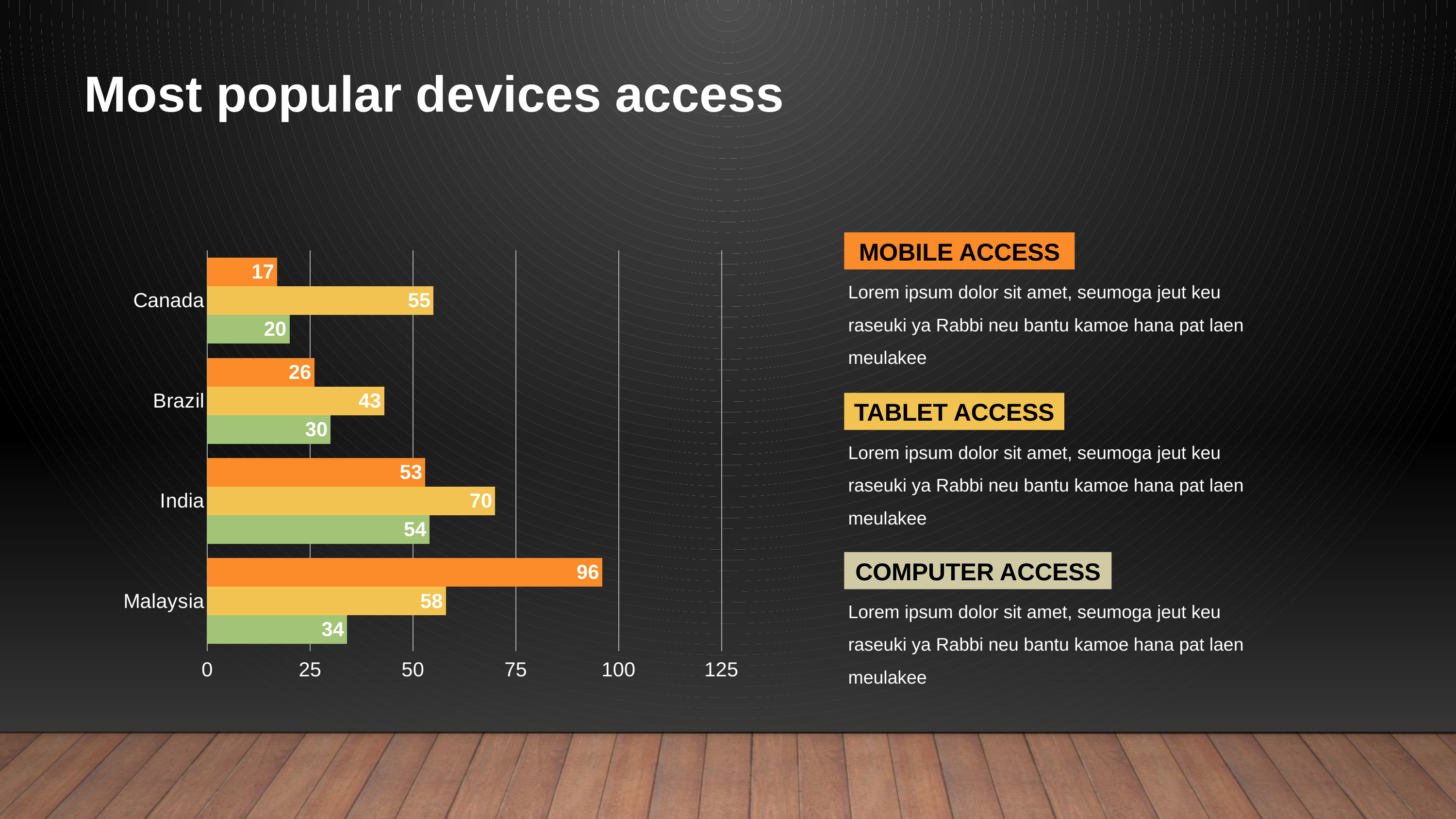
What is the Computer Access (green bar) value for Brazil? 30 Is the Mobile Access value for Malaysia greater or less than 75? greater What is the Mobile Access (orange bar) value for Malaysia? 96 What is the Tablet Access (yellow bar) value for India? 70 Which country has the lowest Computer Access (green bar) value? Canada What is the title of the slide containing the chart? Most popular devices access What type of chart is shown on the slide? bar chart What is the difference between the Tablet Access values for India and Brazil? 27 Which is larger for Canada: the Tablet Access value or the Computer Access value? Tablet Access What is the Mobile Access (orange bar) value for Canada? 17 How many countries are shown on the chart? 4 Which country has the highest Mobile Access (orange bar) value? Malaysia